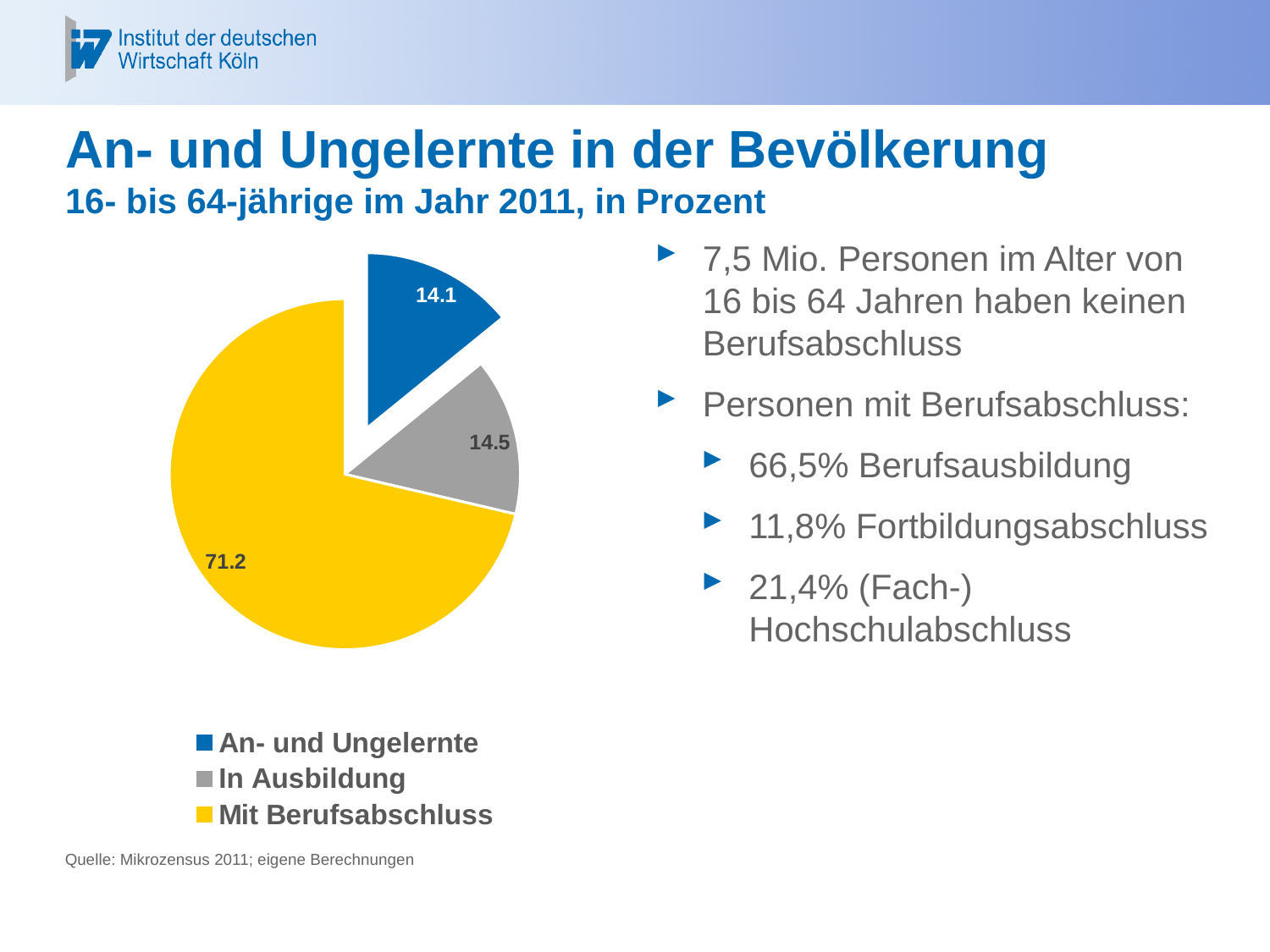
What share of the pie does the "Mit Berufsabschluss" slice represent? 71.2 What is the difference between the values for "Mit Berufsabschluss" and "An- und Ungelernte" in the pie chart? 57.1 Which category has the largest slice in the pie chart? Mit Berufsabschluss What value is shown for the "An- und Ungelernte" slice of the pie chart? 14.1 What value is shown for the "Mit Berufsabschluss" slice of the pie chart? 71.2 What value is shown for the "In Ausbildung" slice of the pie chart? 14.5 How many entries does the legend of the pie chart list? 3 Which colour represents "An- und Ungelernte" in the pie chart? Blue What kind of chart is shown on the slide? Pie chart How many slices does the pie chart have? 3 Which is larger in the pie chart: "Mit Berufsabschluss" or "In Ausbildung"? Mit Berufsabschluss What is the difference between the values for "Mit Berufsabschluss" and "In Ausbildung" in the pie chart? 56.7